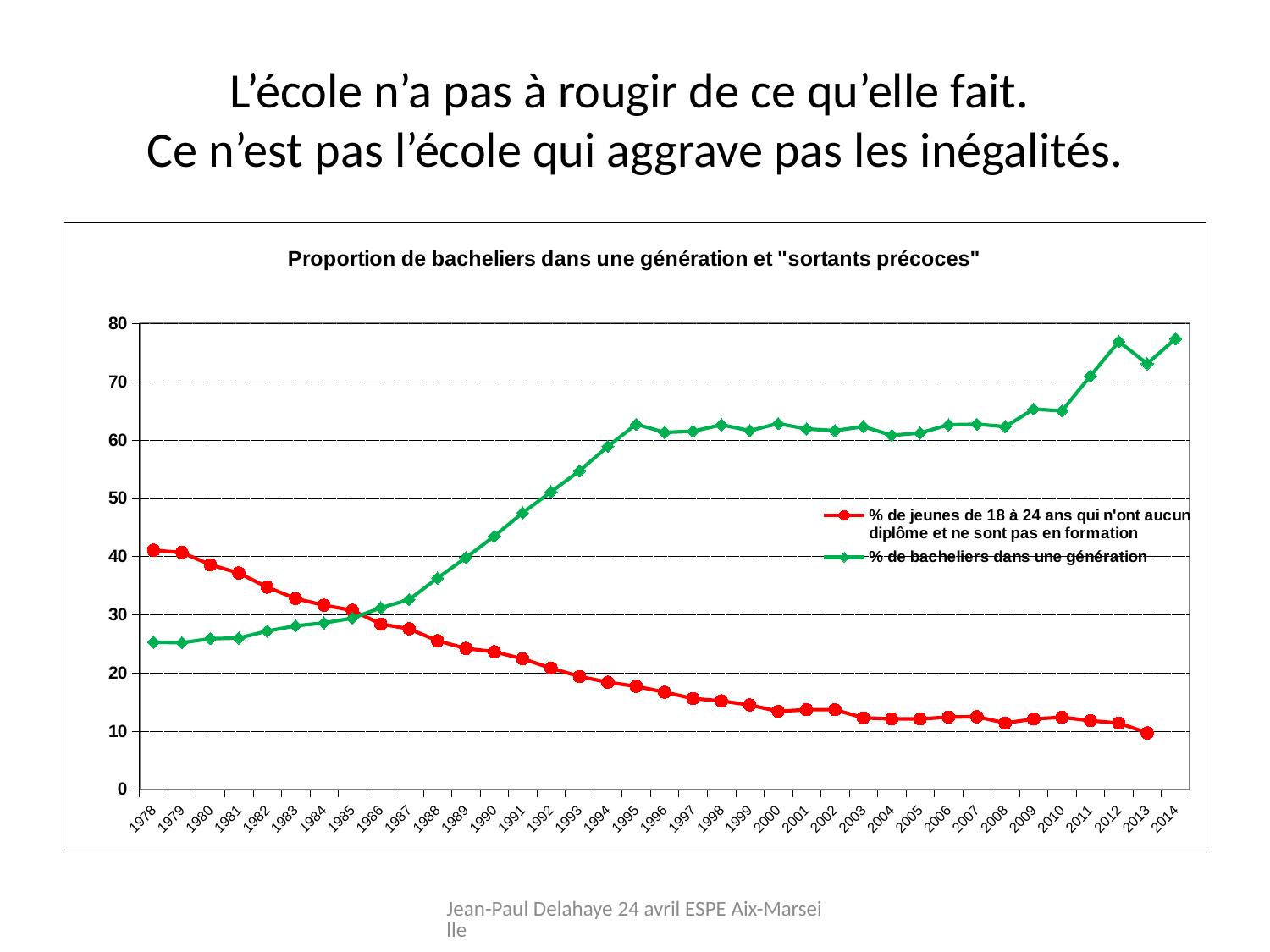
Is the value for '% de bacheliers dans une génération' in 2014 greater or less than 70? greater Does the series '% de jeunes de 18 à 24 ans qui n'ont aucun diplôme et ne sont pas en formation' rise or fall from 1978 to 2013? fall How many years are plotted along the x axis? 37 What is the title of the chart? Proportion de bacheliers dans une génération et "sortants précoces" In which year is the series '% de jeunes de 18 à 24 ans qui n'ont aucun diplôme et ne sont pas en formation' at its lowest? 2013 Is the value for '% de jeunes de 18 à 24 ans qui n'ont aucun diplôme et ne sont pas en formation' in 2000 greater or less than 20? less What is the first year shown on the x axis? 1978 Is the value for '% de bacheliers dans une génération' in 1990 greater or less than 50? less What kind of chart is shown on the slide? line chart How many series does the legend list? 2 In 1978, which series has the higher value: '% de bacheliers dans une génération' or '% de jeunes de 18 à 24 ans qui n'ont aucun diplôme et ne sont pas en formation'? % de jeunes de 18 à 24 ans qui n'ont aucun diplôme et ne sont pas en formation Does the series '% de bacheliers dans une génération' rise or fall from 1978 to 2014? rise